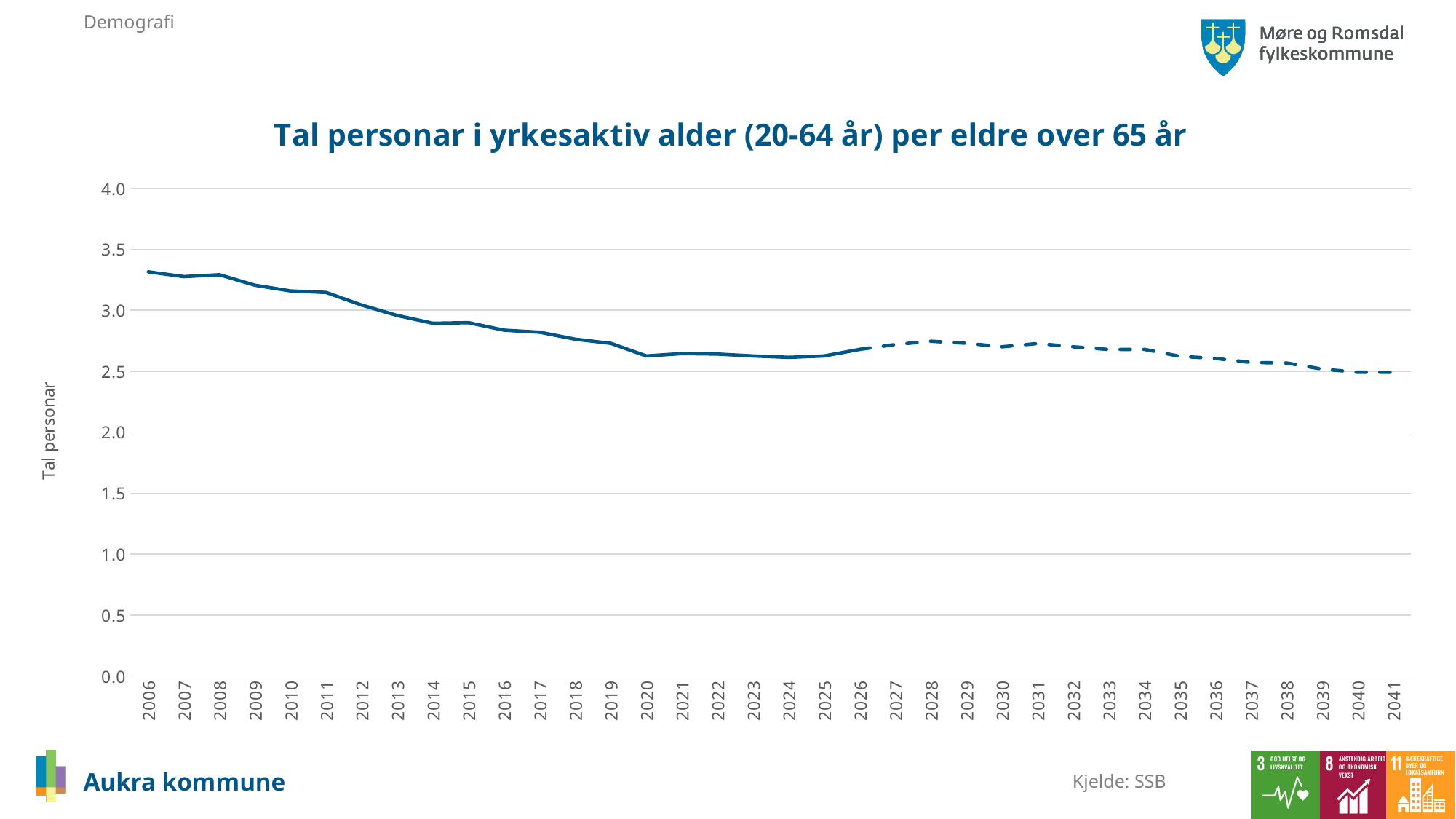
How many years are shown along the x axis of the chart? 36 What is the title of the chart? Tal personar i yrkesaktiv alder (20-64 år) per eldre over 65 år Is the value for 2006 greater or less than 3.0? greater What kind of chart is shown on the slide? line chart Which year has the larger value, 2010 or 2020? 2010 Is the value for 2028 greater or less than 2.5? greater Is the value for 2020 greater or less than 3.0? less What is the label on the vertical axis of the chart? Tal personar Which year has the larger value, 2006 or 2041? 2006 Do the values generally rise or fall from 2006 to 2041? fall